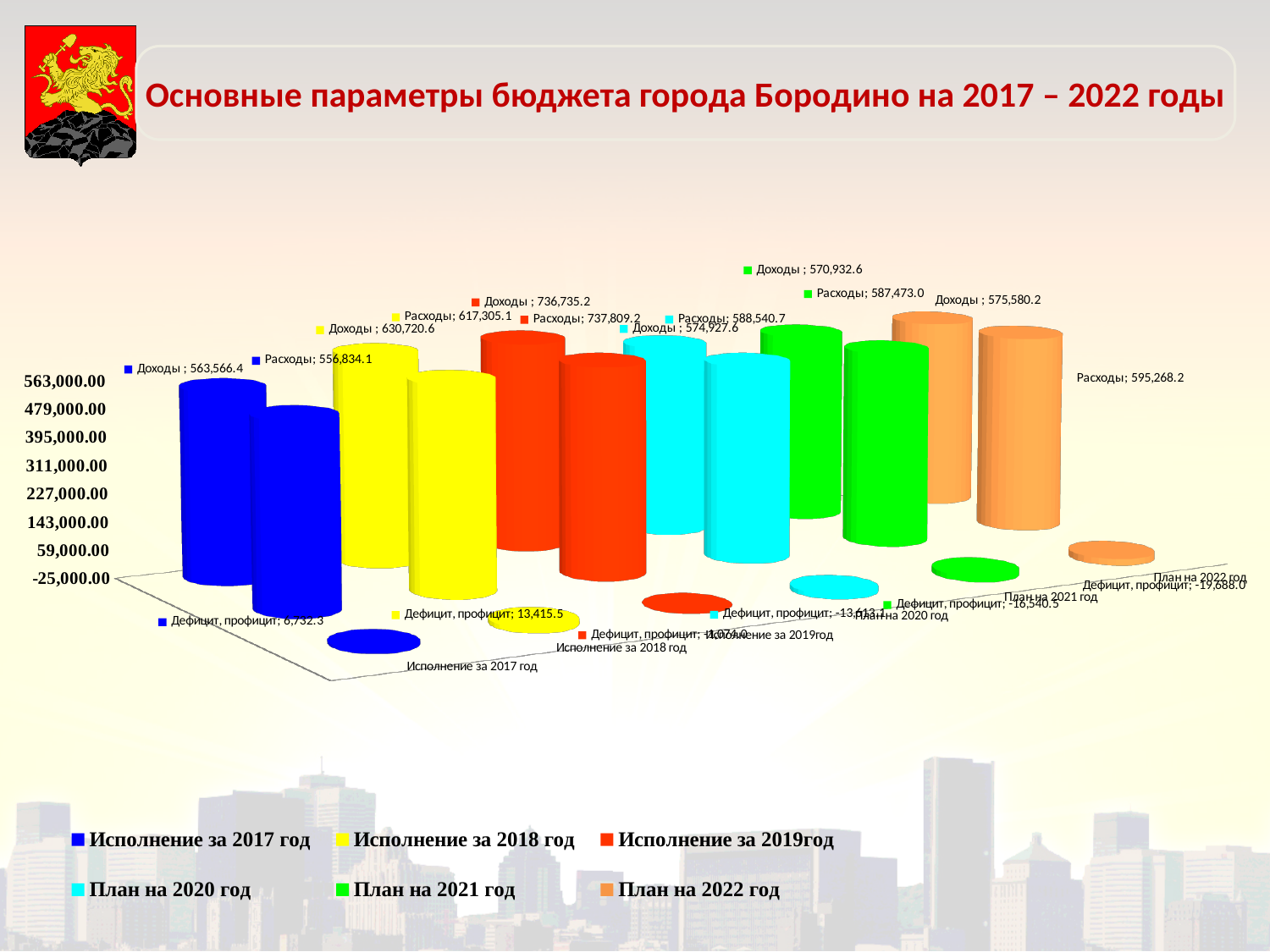
Which series has the highest Доходы value? Исполнение за 2019год For Исполнение за 2019год, which is larger: Доходы or Расходы? Расходы What is the value of Расходы for План на 2022 год? 595,268.2 What is the difference between Доходы and Расходы for Исполнение за 2018 год? 13,415.5 What kind of chart is shown on the slide? bar chart What is the value of Доходы for Исполнение за 2019год? 736,735.2 Which series has the lowest Доходы value? Исполнение за 2017 год What is the value of Расходы for План на 2020 год? 588,540.7 How many series does the legend list? 6 What is the value of Дефицит, профицит for План на 2021 год? -16,540.5 What colour represents План на 2022 год in the legend? orange What is the value of Доходы for Исполнение за 2017 год? 563,566.4